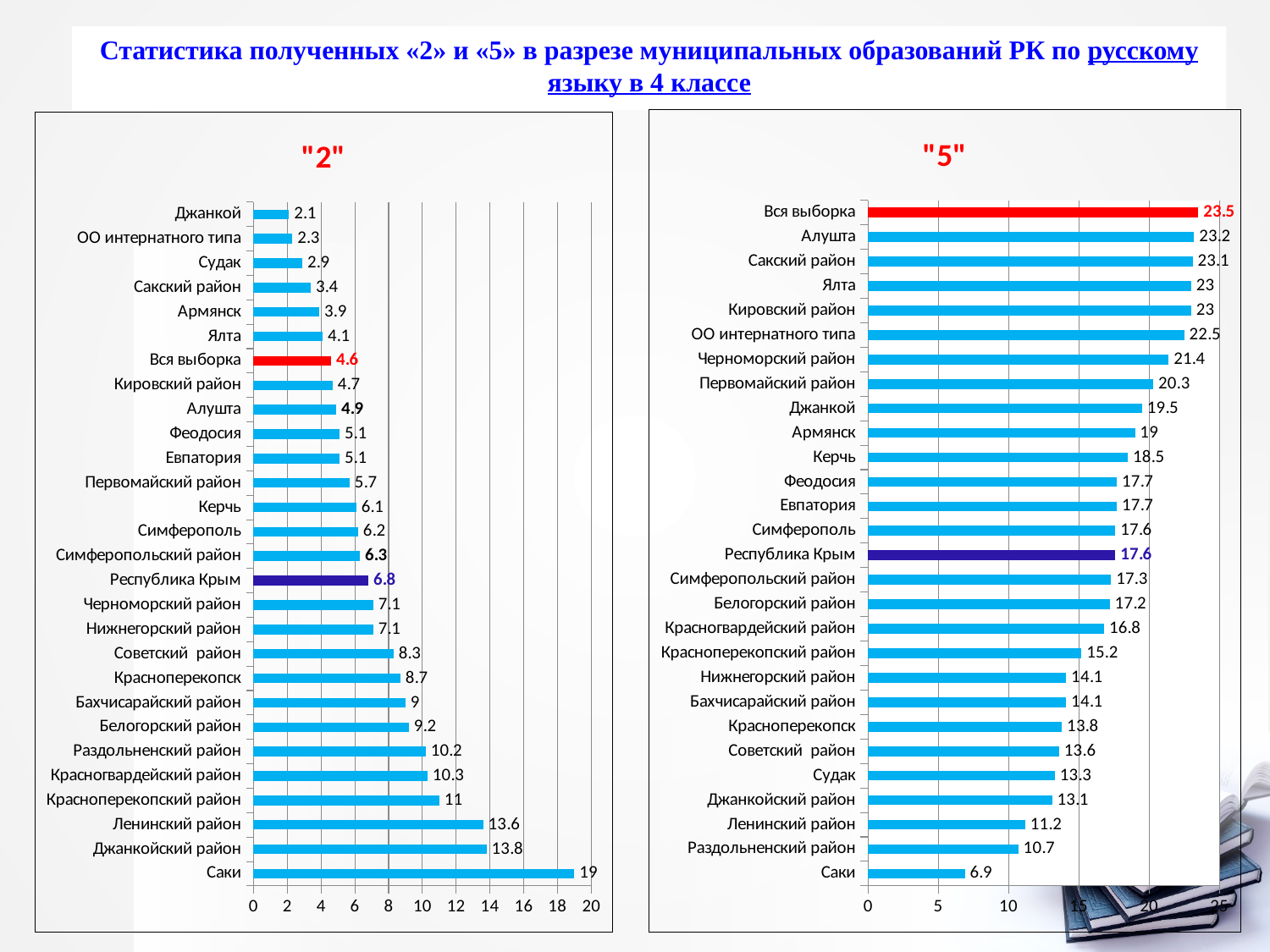
In the "2" chart, which is larger, the value for Керчь or the value for Ялта? Керчь In the "5" chart, what is the value for Вся выборка? 23.5 In the "2" chart, what is the value for Саки? 19 In the "5" chart, which category has the highest value? Вся выборка How many categories are shown in the "5" chart? 28 In the "5" chart, what is the difference between Алушта and Ленинский район? 12 In the "2" chart, what is the value for Республика Крым? 6.8 What type of chart is the "2" chart? bar chart In the "5" chart, what colour is the bar for Вся выборка? red In the "2" chart, which category has the lowest value? Джанкой In the "2" chart, what is the difference between Джанкойский район and Джанкой? 11.7 In the "5" chart, what is the value for Саки? 6.9